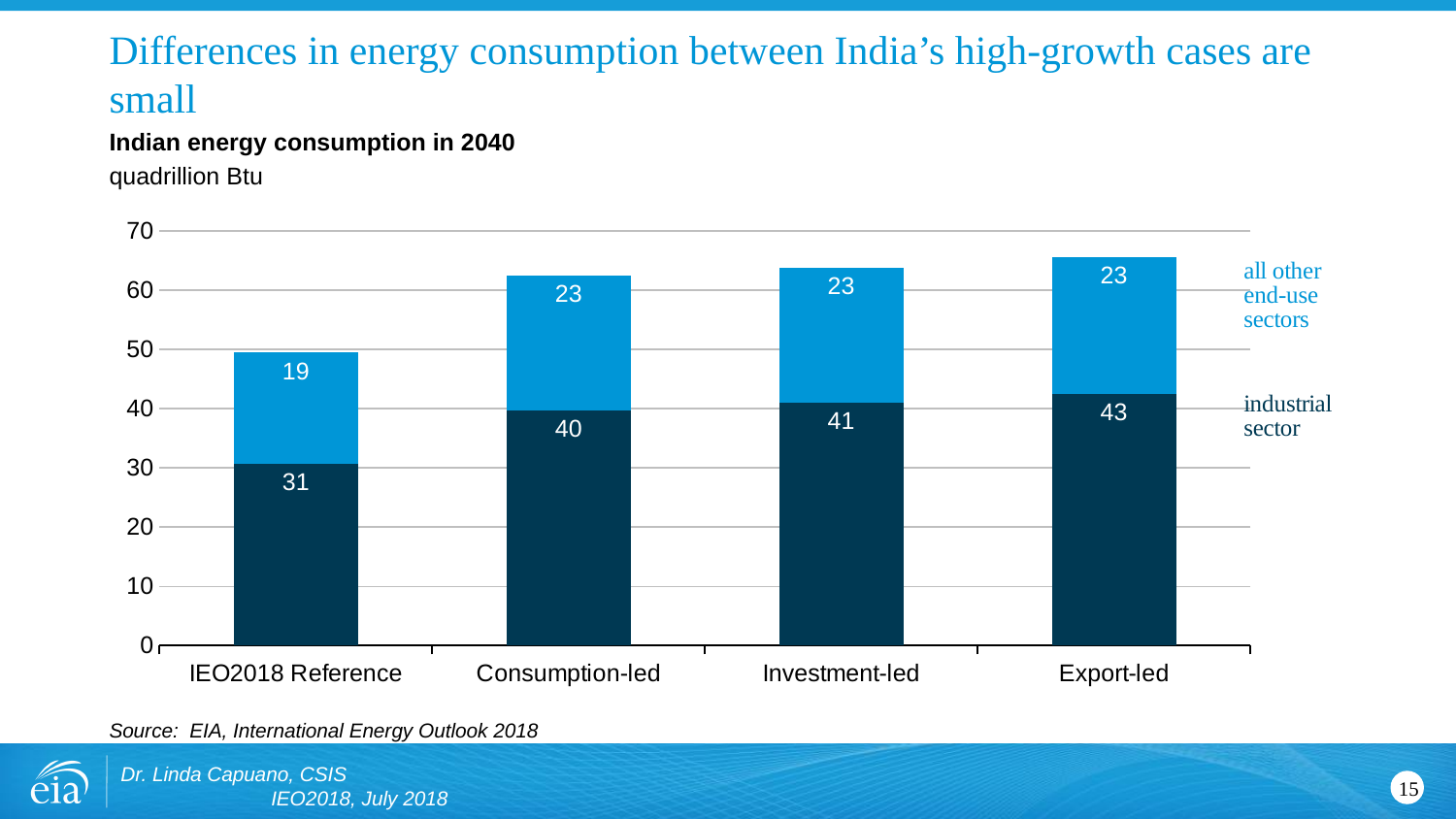
What is the difference between the industrial sector values for Export-led and IEO2018 Reference? 12 Is the industrial sector value for Investment-led larger or smaller than that for Consumption-led? larger What is the all other end-use sectors value for the IEO2018 Reference case? 19 What is the total energy consumption for the IEO2018 Reference case? 50 What is the total energy consumption for the Investment-led case? 64 What is the industrial sector value for the Consumption-led case? 40 What kind of chart is this? stacked bar chart Which case has the lowest industrial sector value? IEO2018 Reference Which case has the highest industrial sector value? Export-led How many cases are shown on the x axis? 4 What is the industrial sector value for the Export-led case? 43 How many series does the chart show? 2